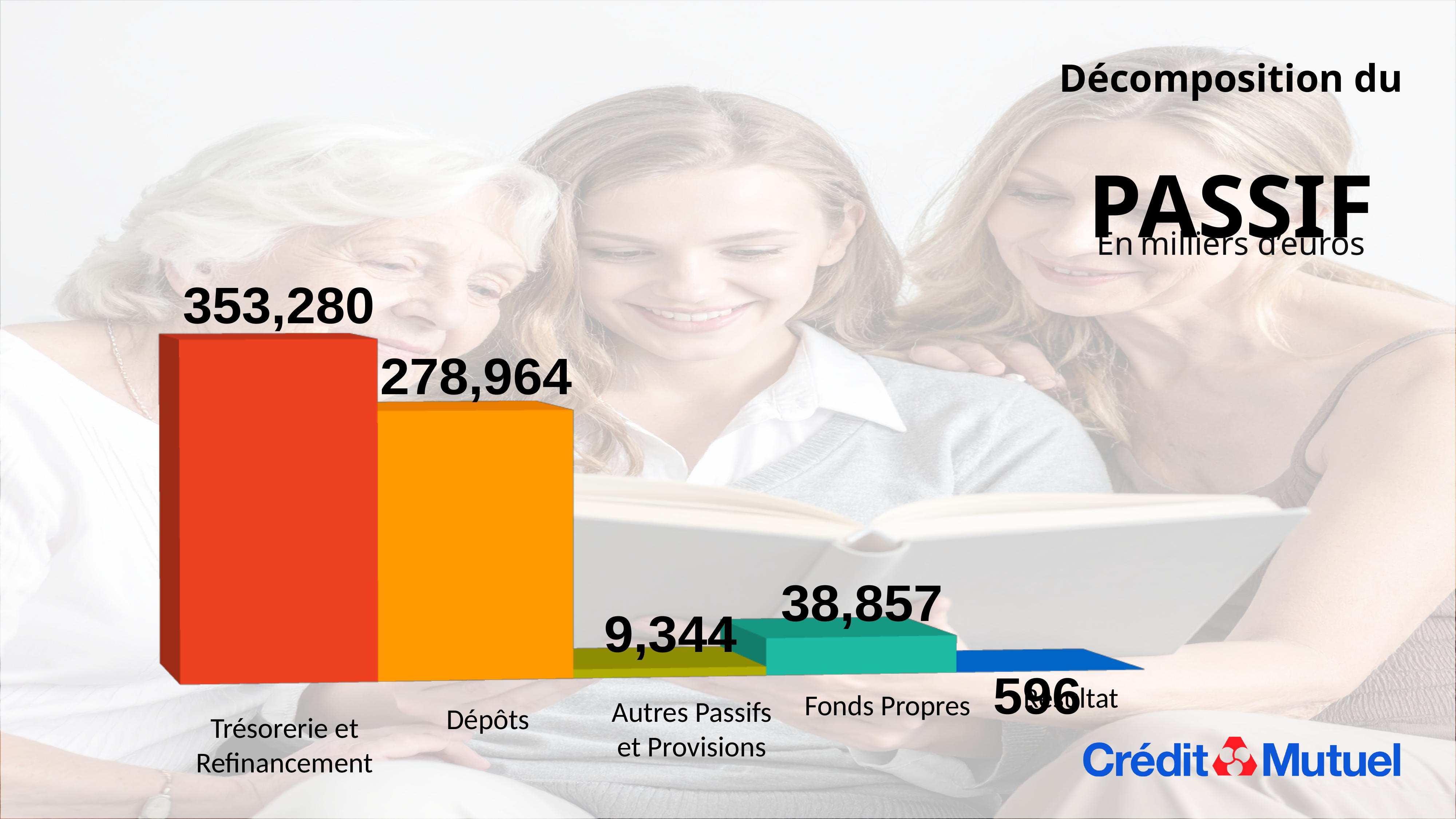
Which category has the lowest value? Résultat In what unit are the chart values expressed, according to the slide? En milliers d'euros What is the value for Trésorerie et Refinancement? 353,280 What is the value for Fonds Propres? 38,857 What is the value for Autres Passifs et Provisions? 9,344 Which category has the highest value? Trésorerie et Refinancement How many categories are shown in the chart? 5 Which is larger, Fonds Propres or Autres Passifs et Provisions? Fonds Propres What is the difference between Trésorerie et Refinancement and Dépôts? 74,316 What is the value for Dépôts? 278,964 What kind of chart is shown on the slide? Bar chart What is the difference between Fonds Propres and Autres Passifs et Provisions? 29,513